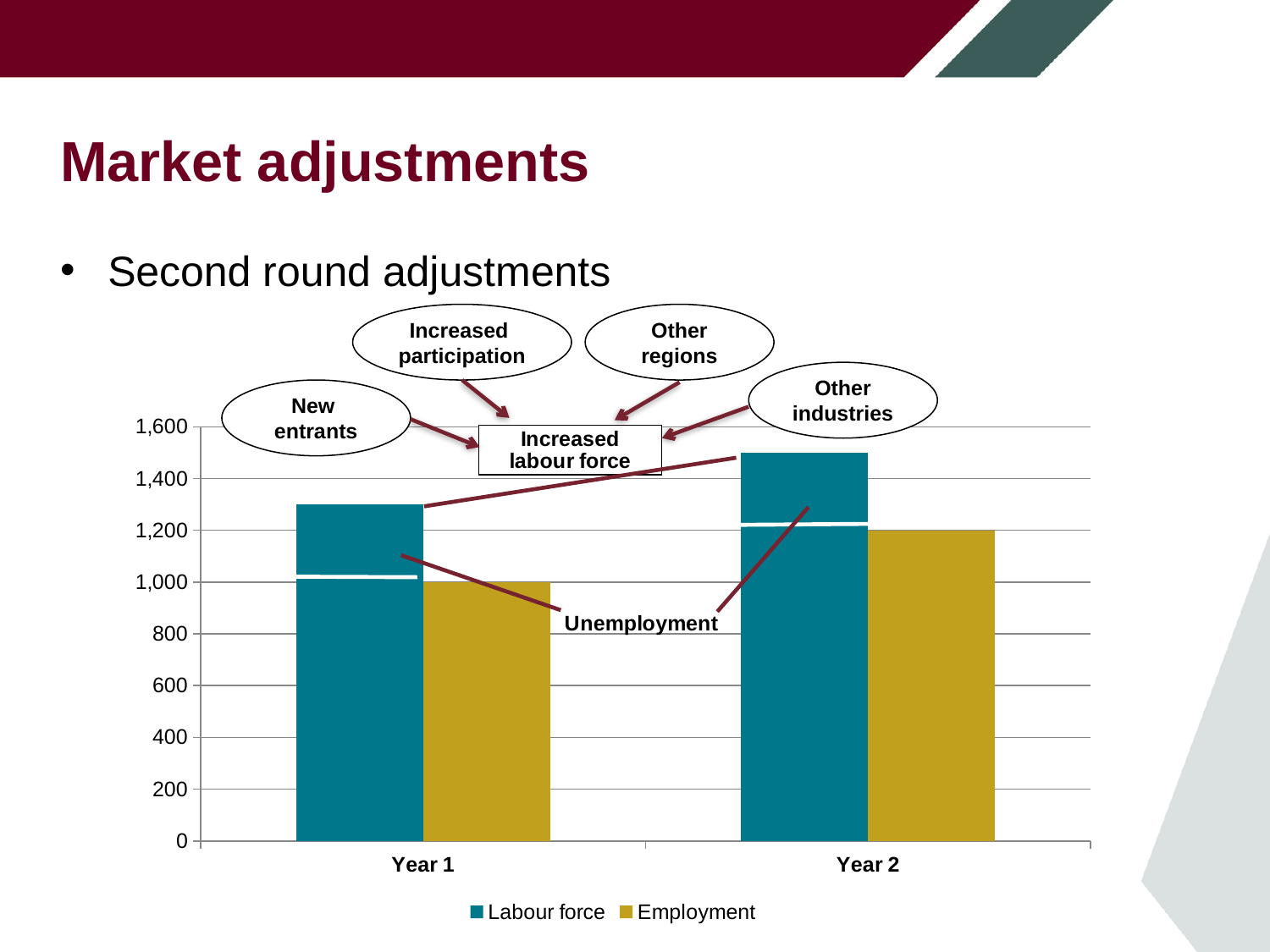
What is the Employment value for Year 2? 1,200 Is the Labour force value for Year 2 greater or less than 1,600? less What is the Employment value for Year 1? 1,000 Is the Labour force value for Year 1 greater or less than 1,200? greater What kind of chart is shown on the slide? Bar chart In Year 1, which is larger: Labour force or Employment? Labour force Does the Labour force rise or fall from Year 1 to Year 2? Rise By how much does Employment increase from Year 1 to Year 2? 200 Which bar is the shortest in the chart? Employment, Year 1 How many series does the chart legend list? 2 How many categories are shown on the x axis of the chart? 2 Which bar is the tallest in the chart? Labour force, Year 2